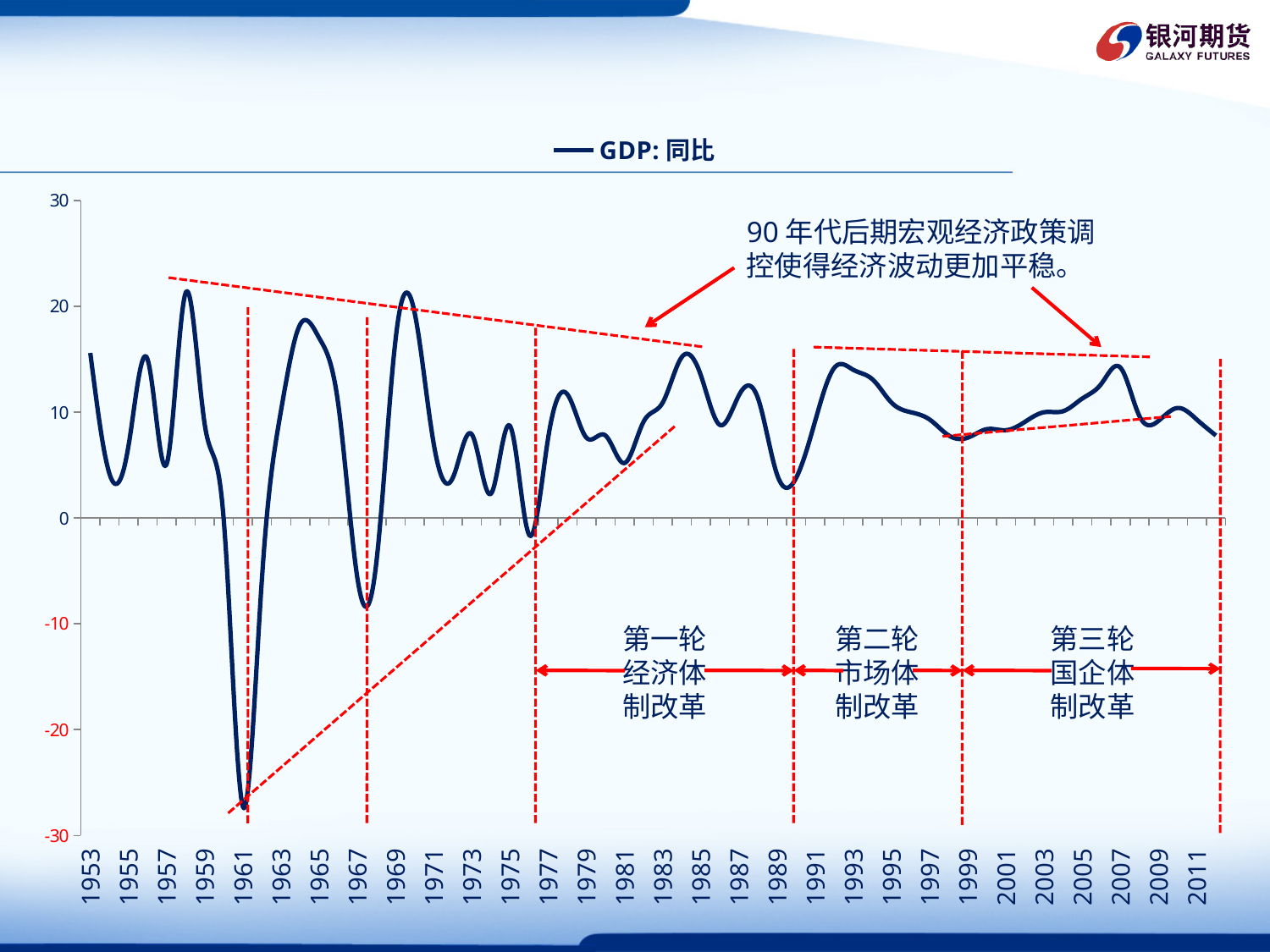
What is the label of the reform period marked between the dashed lines at 1990 and 1999? 第二轮市场体制改革 Is the value for 1958 greater or less than 20? greater In which year does the GDP: 同比 line reach its lowest point? 1961 Is the value for 1984 greater or less than 10? greater Which year has the lower value, 1961 or 1967? 1961 How many series does the legend list? 1 Is the value for 1990 greater or less than 10? less What kind of chart is shown on the slide? line chart Does the GDP: 同比 line rise or fall from 2007 to the end of the series? fall What is the name of the series shown in the legend? GDP: 同比